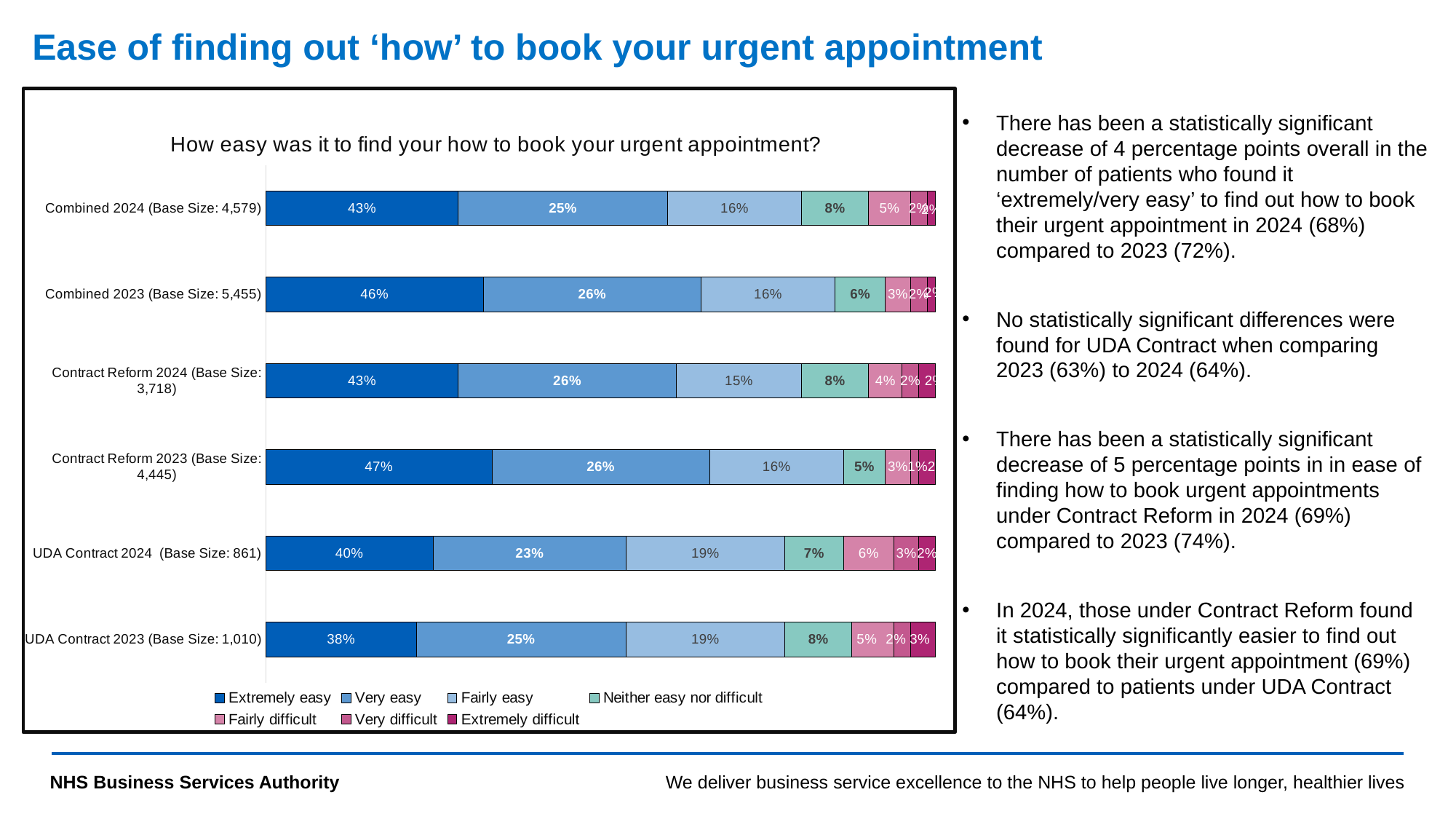
What percentage of Combined 2024 respondents said it was 'Extremely easy'? 43% Which category has the lowest 'Extremely easy' percentage? UDA Contract 2023 (Base Size: 1,010) How many series does the chart legend list? 7 Which has a larger 'Fairly easy' share: UDA Contract 2024 or Combined 2024? UDA Contract 2024 What is the 'Neither easy nor difficult' value for Contract Reform 2023? 5% How many categories (bars) are plotted in the chart? 6 Which category has the highest 'Extremely easy' percentage? Contract Reform 2023 (Base Size: 4,445) What is the 'Very easy' value for UDA Contract 2024? 23% What is the 'Fairly difficult' value for UDA Contract 2024? 6% What kind of chart is shown on the slide? Stacked bar chart What is the difference in the 'Extremely easy' percentage between Combined 2023 and Combined 2024? 3 percentage points What is the title of the chart? How easy was it to find your how to book your urgent appointment?